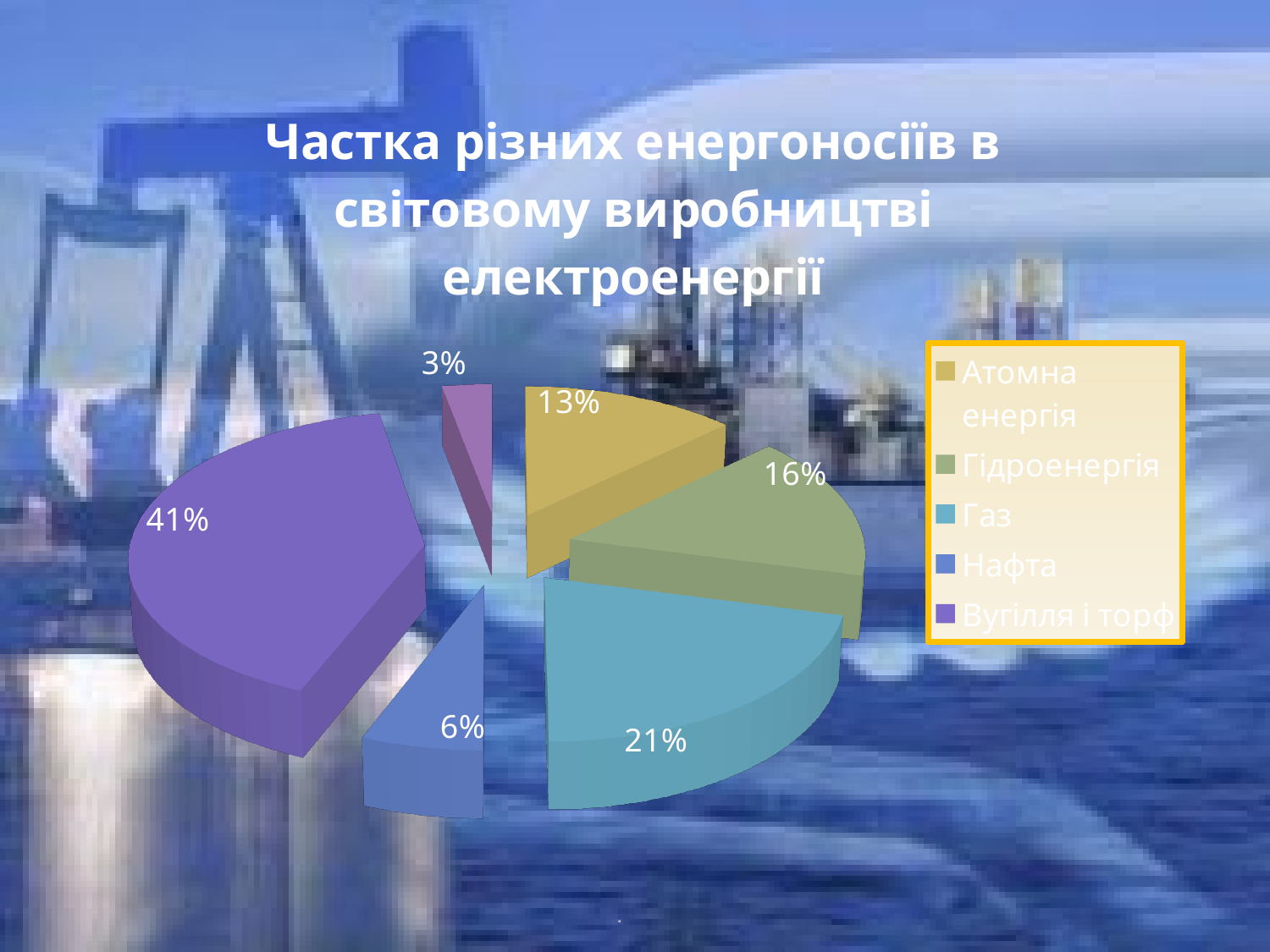
What percentage is shown for Нафта? 6% What is the smallest percentage labelled on the pie chart? 3% What percentage is shown for Атомна енергія? 13% What percentage is shown for Гідроенергія? 16% By how many percentage points does Вугілля і торф exceed Газ? 20% Which has the larger share, Газ or Гідроенергія? Газ What kind of chart is shown on the slide? pie chart Which energy source has the largest slice of the pie? Вугілля і торф What is the title of the chart? Частка різних енергоносіїв в світовому виробництві електроенергії What share of world electricity production does Вугілля і торф account for? 41% How many entries does the chart legend list? 5 What percentage is shown for Газ? 21%